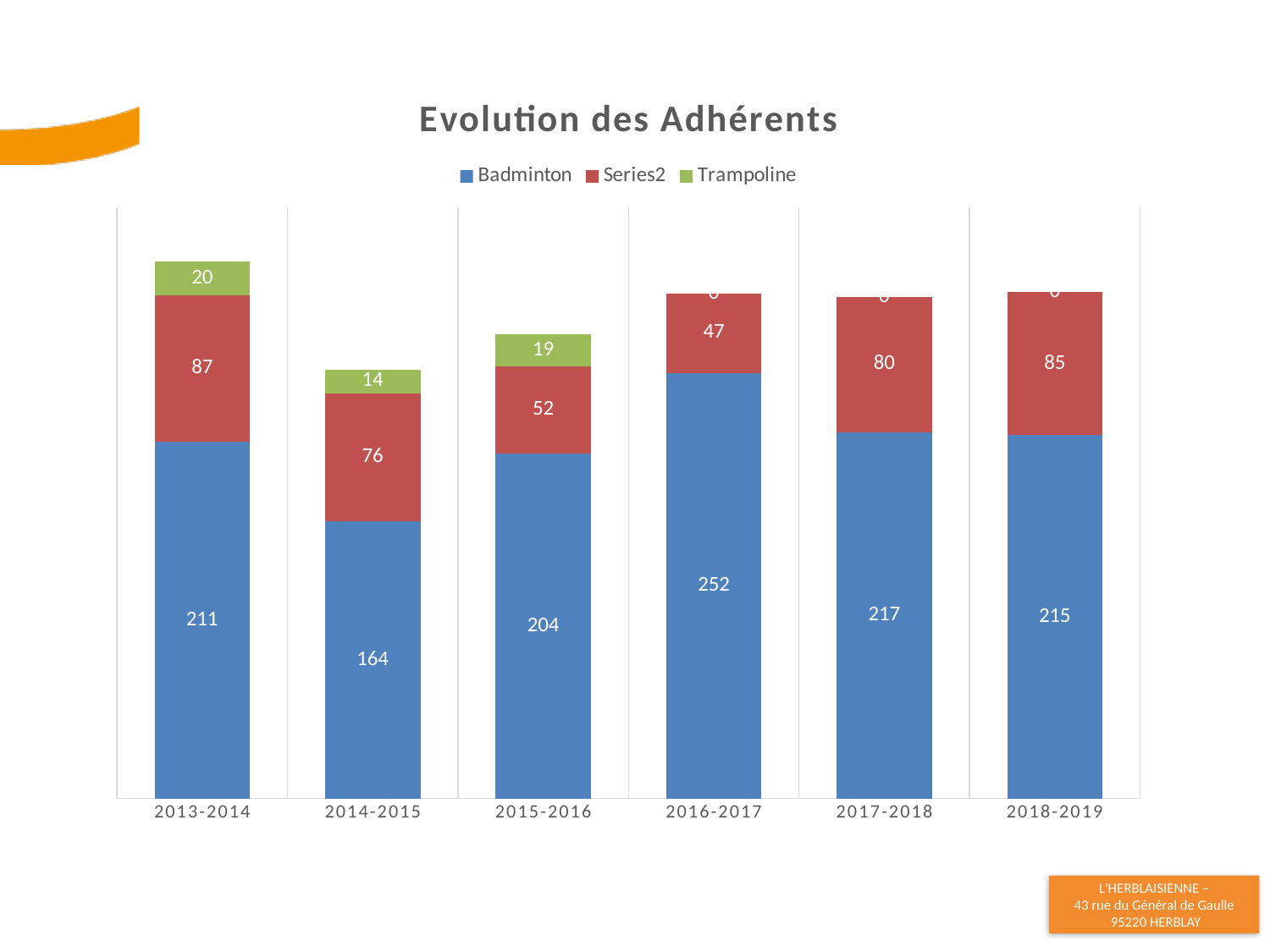
What is the difference between the Badminton values for 2016-2017 and 2014-2015? 88 How many seasons are shown on the x axis? 6 Which season has the lowest Badminton value? 2014-2015 What is the title of the chart? Evolution des Adhérents What is the Series2 value for 2014-2015? 76 What type of chart is shown on the slide? Stacked bar chart What is the Trampoline value for 2015-2016? 19 What is the Badminton value for 2016-2017? 252 Which is larger, the Series2 value for 2013-2014 or for 2018-2019? 2013-2014 Which season has the highest Badminton value? 2016-2017 What is the total of the stacked bar for 2013-2014? 318 How many series does the legend list? 3